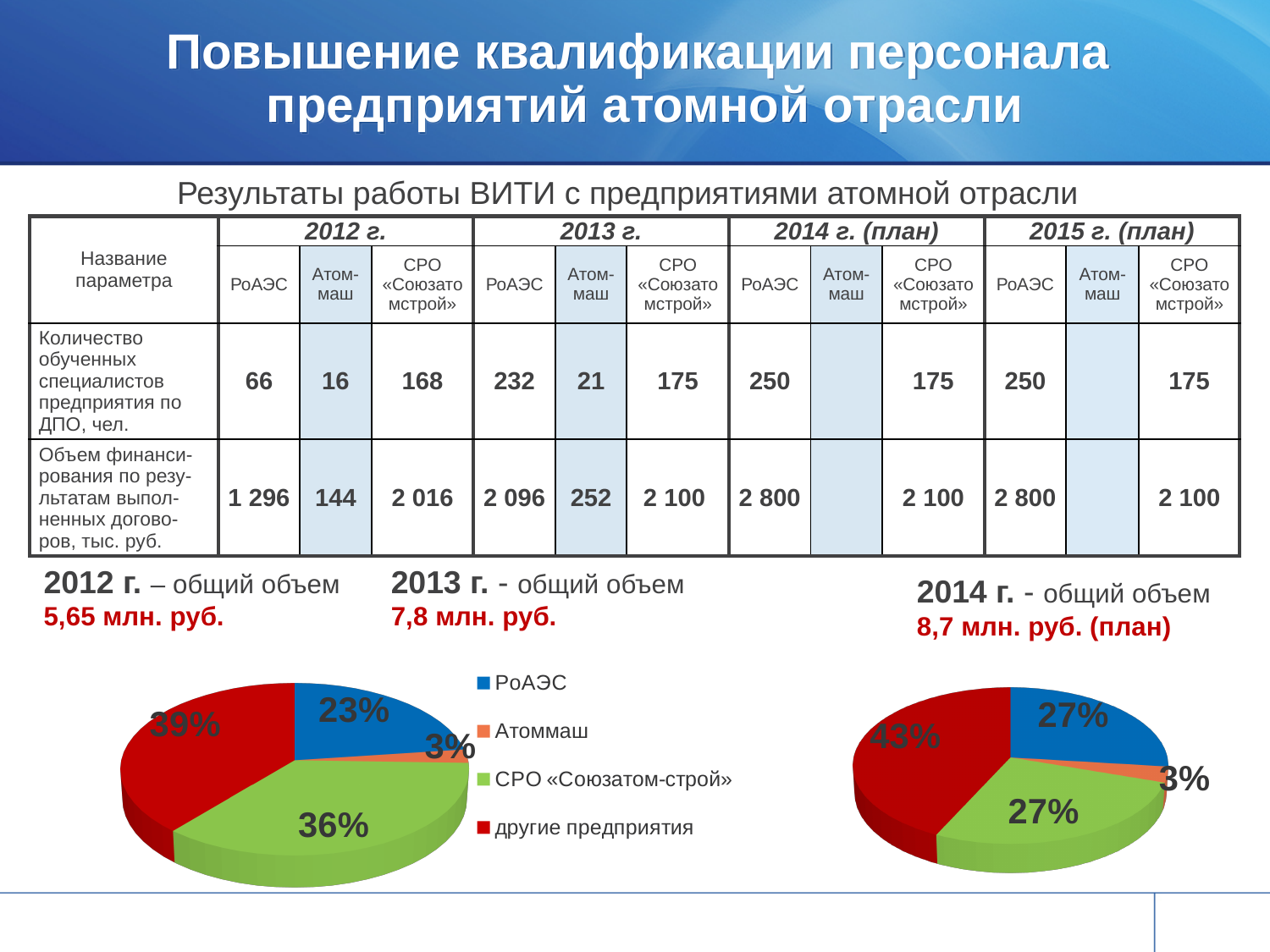
In the left pie chart, what share does Атоммаш have? 3% In the left pie chart, what share does СРО «Союзатом-строй» have? 36% In the right pie chart, what share does РоАЭС have? 27% What kind of chart is shown at the bottom left of the slide? pie chart In the right pie chart, what share does другие предприятия have? 43% In the left pie chart, which category has the largest share? другие предприятия How many entries does the legend between the two pie charts list? 4 In the right pie chart, which category has the smallest share? Атоммаш In the left pie chart, what share does РоАЭС have? 23% In the legend, which colour represents СРО «Союзатом-строй»? green In the left pie chart, which category has the smallest share? Атоммаш In the left pie chart, what is the difference between the shares of другие предприятия and РоАЭС? 16%